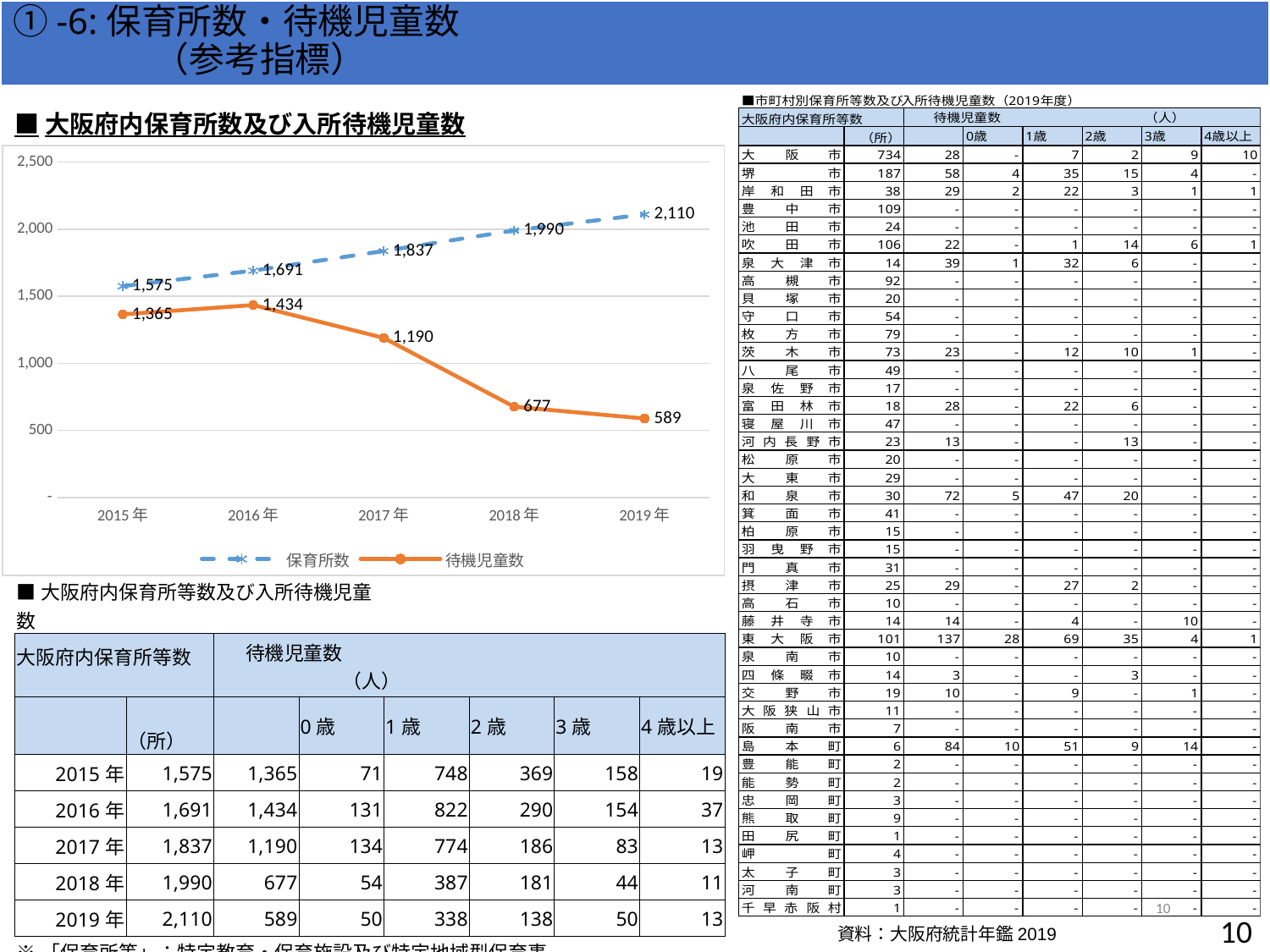
What is the difference between 保育所数 and 待機児童数 in 2019年? 1,521 What is the value of 保育所数 in 2019年? 2,110 In which year is 待機児童数 lowest? 2019年 How many series does the chart legend list? 2 What is the difference in 待機児童数 between 2017年 and 2018年? 513 How many years are shown on the x axis of the chart? 5 In which year is 保育所数 lowest? 2015年 Which is larger in 2016年, 保育所数 or 待機児童数? 保育所数 What is the value of 待機児童数 in 2015年? 1,365 In which year is 待機児童数 highest? 2016年 What is the value of 待機児童数 in 2017年? 1,190 What kind of chart is shown on the slide? Line chart